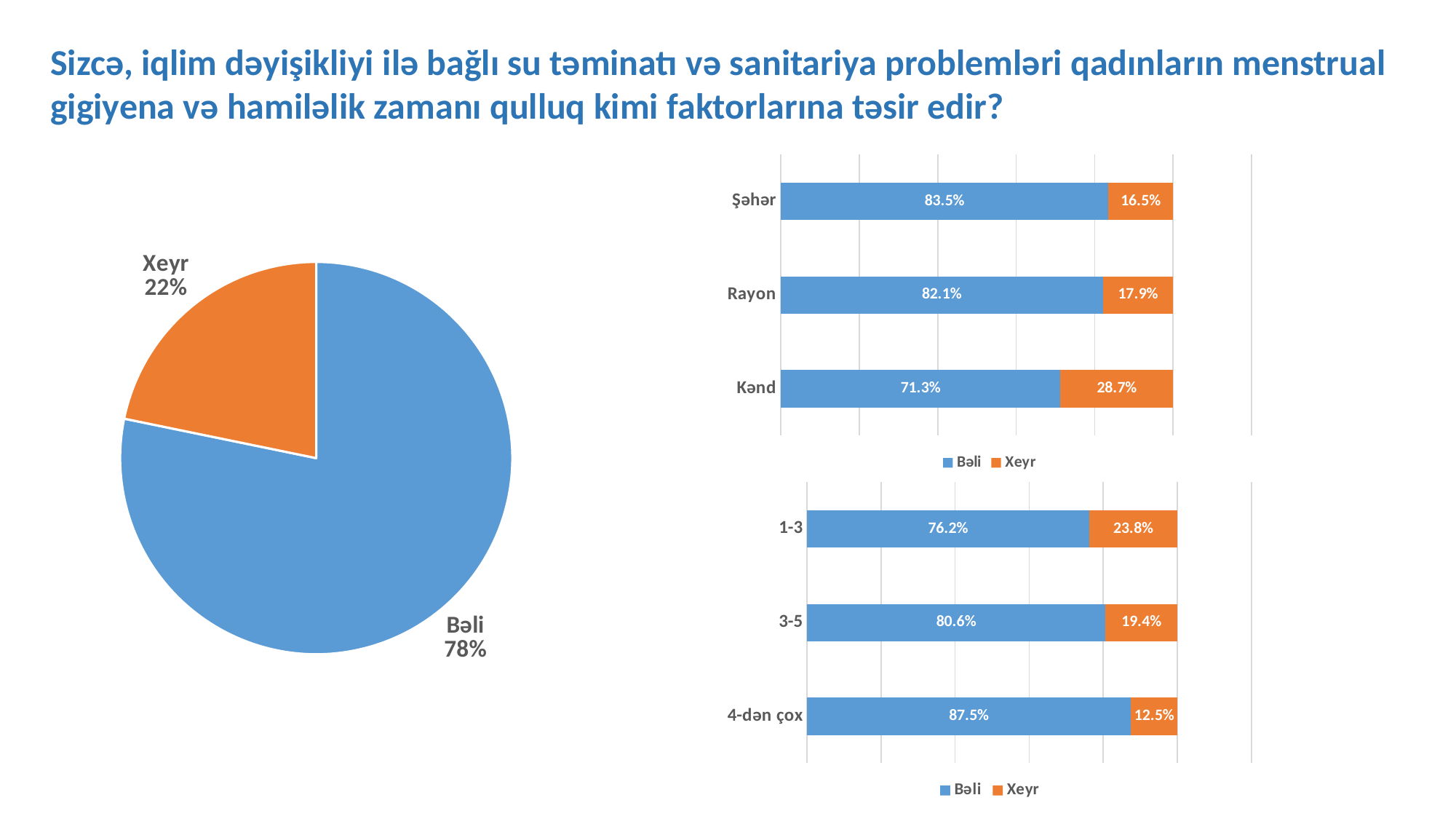
In the bottom-right bar chart, which category has the highest Xeyr value? 1-3 In the top-right bar chart, what is the Bəli value for Şəhər? 83.5% In the pie chart on the left, what share does the Bəli slice have? 78% In the top-right bar chart, what is the difference between the Bəli values for Şəhər and Rayon? 1.4% How many series does the legend of the bottom-right bar chart list? 2 In the top-right bar chart, what is the Xeyr value for Kənd? 28.7% In the bottom-right bar chart, is the Bəli value for 3-5 larger or smaller than the Bəli value for 1-3? Larger What kind of chart is the chart on the left of the slide? Pie chart In the bottom-right bar chart, what is the Bəli value for 4-dən çox? 87.5% In the pie chart on the left, what share does the Xeyr slice have? 22% How many categories are shown in the top-right bar chart? 3 In the top-right bar chart, which category has the lowest Bəli value? Kənd